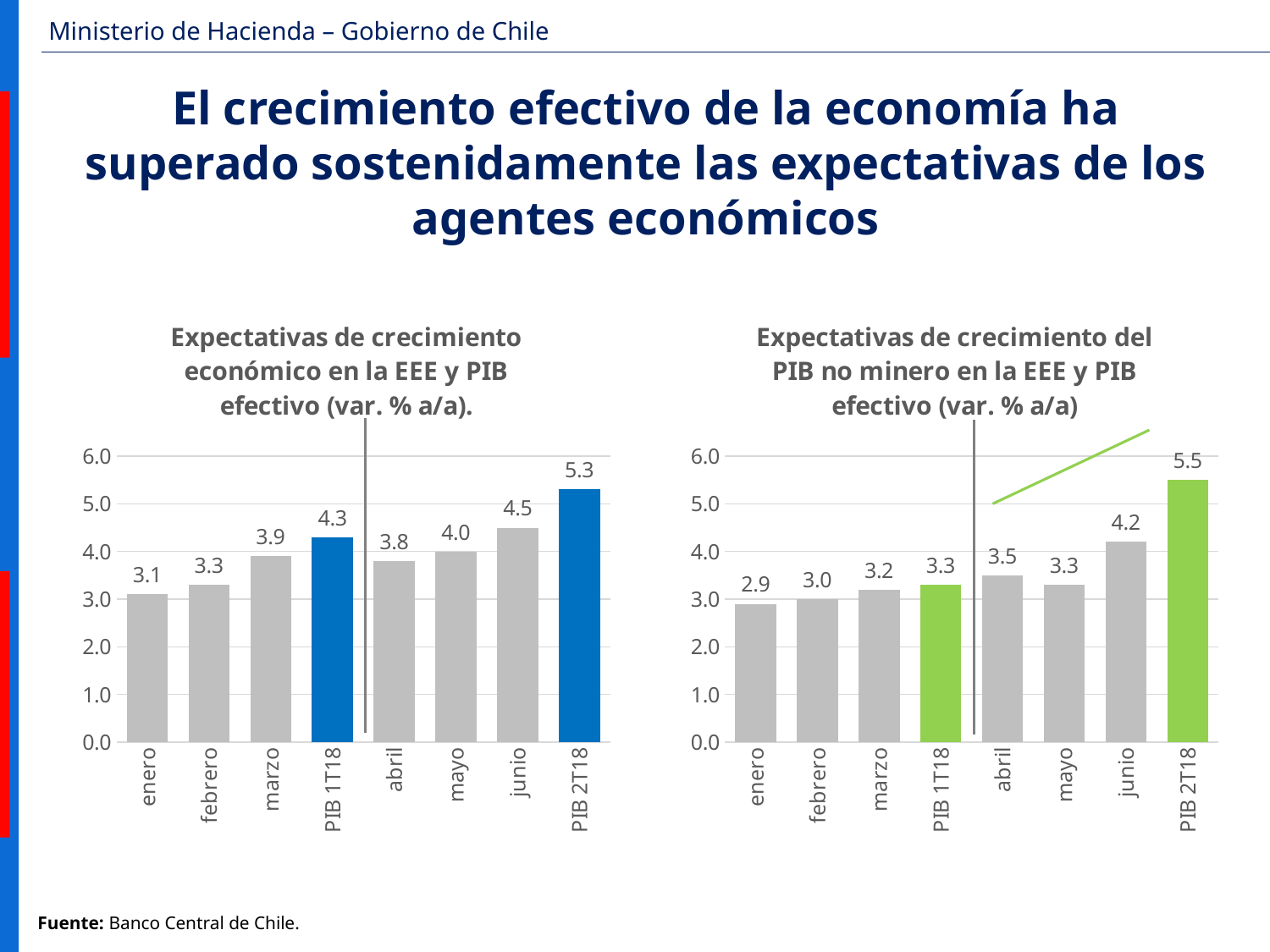
In the right chart (Expectativas de crecimiento del PIB no minero en la EEE y PIB efectivo), is the value for enero greater or less than 3.0? less In the right chart (Expectativas de crecimiento del PIB no minero en la EEE y PIB efectivo), what is the difference between PIB 2T18 and PIB 1T18? 2.2 In the left chart (Expectativas de crecimiento económico en la EEE y PIB efectivo), what colour are the PIB 1T18 and PIB 2T18 bars? blue In the left chart (Expectativas de crecimiento económico en la EEE y PIB efectivo), what is the value for marzo? 3.9 In the left chart (Expectativas de crecimiento económico en la EEE y PIB efectivo), what is the value for PIB 2T18? 5.3 In the left chart (Expectativas de crecimiento económico en la EEE y PIB efectivo), which category has the lowest value? enero In the right chart (Expectativas de crecimiento del PIB no minero en la EEE y PIB efectivo), which category has the highest value? PIB 2T18 In the left chart (Expectativas de crecimiento económico en la EEE y PIB efectivo), how many bars are plotted? 8 In the right chart (Expectativas de crecimiento del PIB no minero en la EEE y PIB efectivo), which is larger, the value for junio or the value for mayo? junio In the right chart (Expectativas de crecimiento del PIB no minero en la EEE y PIB efectivo), what is the value for abril? 3.5 What kind of chart is the left chart (Expectativas de crecimiento económico en la EEE y PIB efectivo)? bar chart In the left chart (Expectativas de crecimiento económico en la EEE y PIB efectivo), what is the difference between PIB 2T18 and junio? 0.8